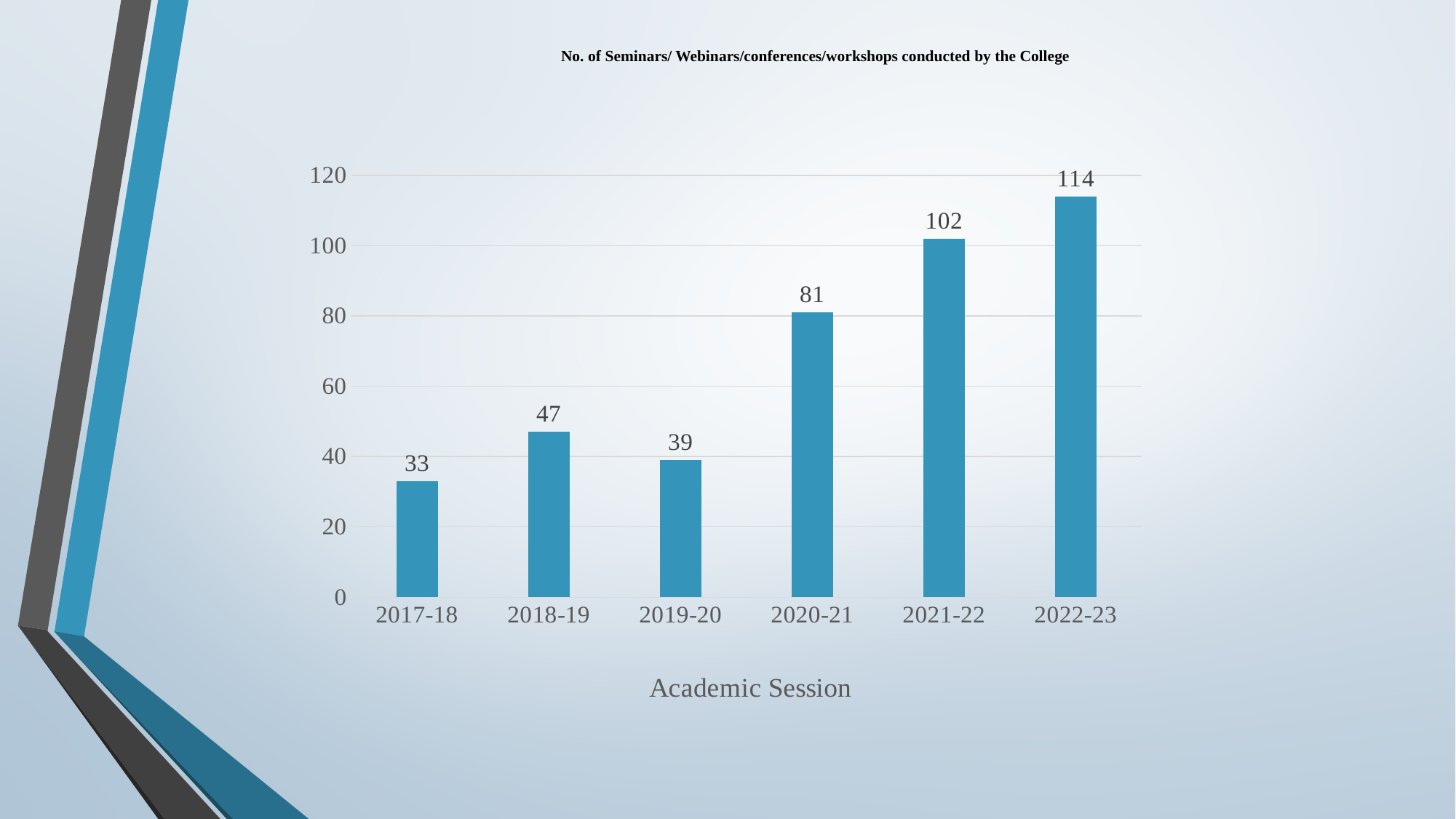
How many academic sessions are shown on the x axis? 6 What is the difference between the values for 2022-23 and 2021-22? 12 What is the difference between the values for 2018-19 and 2019-20? 8 What value is shown for the 2017-18 academic session? 33 Which academic session has the lowest number of seminars/webinars/conferences/workshops? 2017-18 What kind of chart is shown on the slide? Bar chart Is the value for 2021-22 greater or less than 100? greater What is the label of the x axis? Academic Session What value is shown for the 2019-20 academic session? 39 What is the number of seminars/webinars/conferences/workshops conducted in 2020-21? 81 Which is larger, the value for 2018-19 or the value for 2019-20? 2018-19 Which academic session has the highest number of seminars/webinars/conferences/workshops? 2022-23